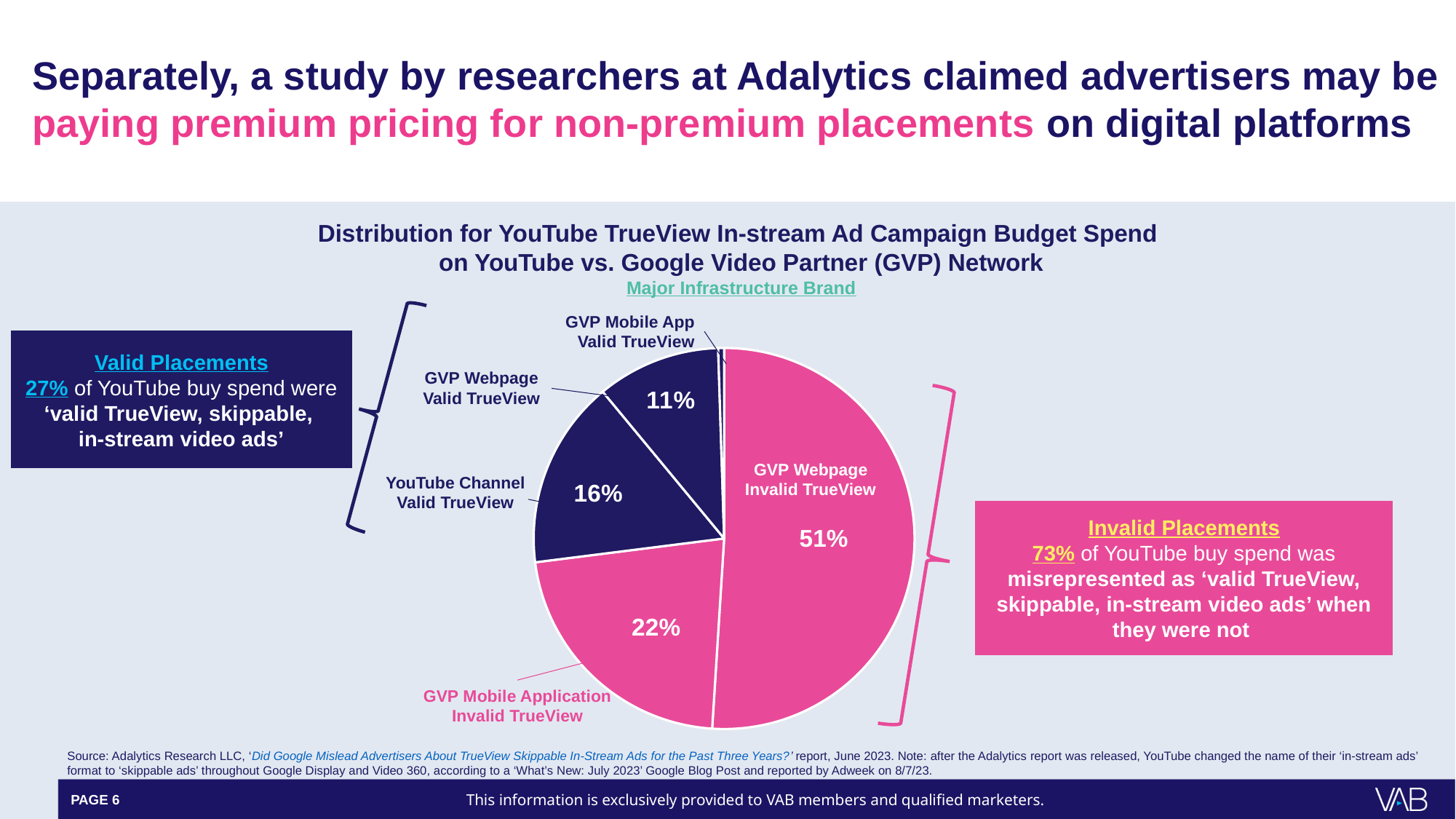
What is the combined share of the two Invalid TrueView slices? 73% What share of the pie is GVP Webpage Invalid TrueView? 51% Which is larger, the YouTube Channel Valid TrueView share or the GVP Webpage Valid TrueView share? YouTube Channel Valid TrueView Which slice of the pie is the largest? GVP Webpage Invalid TrueView What kind of chart is shown on the slide? Pie chart What share of the pie is GVP Mobile Application Invalid TrueView? 22% Which slice of the pie is the smallest? GVP Mobile App Valid TrueView What is the title of the pie chart? Distribution for YouTube TrueView In-stream Ad Campaign Budget Spend on YouTube vs. Google Video Partner (GVP) Network What is the difference between the GVP Webpage Invalid TrueView share and the GVP Mobile Application Invalid TrueView share? 29% What share of the pie is YouTube Channel Valid TrueView? 16% What share of the pie is GVP Webpage Valid TrueView? 11% How many slices are labelled in the pie chart? 5